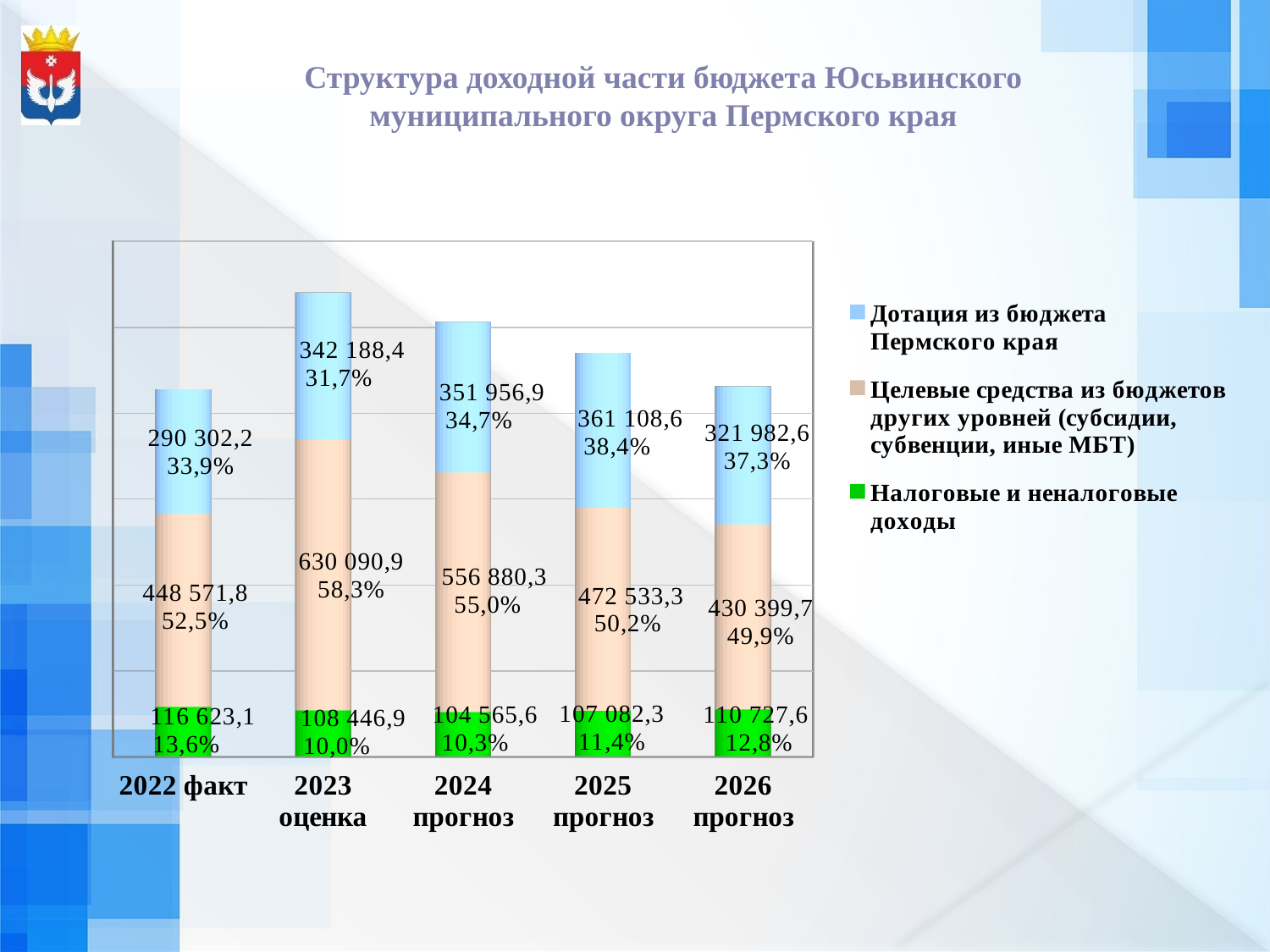
In which year is the value of Налоговые и неналоговые доходы the lowest? 2024 прогноз What is the difference between the Целевые средства values for 2023 оценка and 2022 факт? 181 519,1 What kind of chart is shown on the slide? Stacked bar chart In which year is the value of Дотация из бюджета Пермского края the highest? 2025 прогноз How many years (categories) are shown on the x axis? 5 How many series does the legend list? 3 Which is larger: Дотация из бюджета Пермского края for 2024 прогноз or for 2026 прогноз? 2024 прогноз What is the value of Целевые средства из бюджетов других уровней for 2024 прогноз? 556 880,3 What percentage share of the 2023 оценка bar is Целевые средства из бюджетов других уровней? 58,3% What is the value of Дотация из бюджета Пермского края for 2025 прогноз? 361 108,6 What is the value of Налоговые и неналоговые доходы for 2022 факт? 116 623,1 What is the total of the stacked bar for 2022 факт? 855 497,1